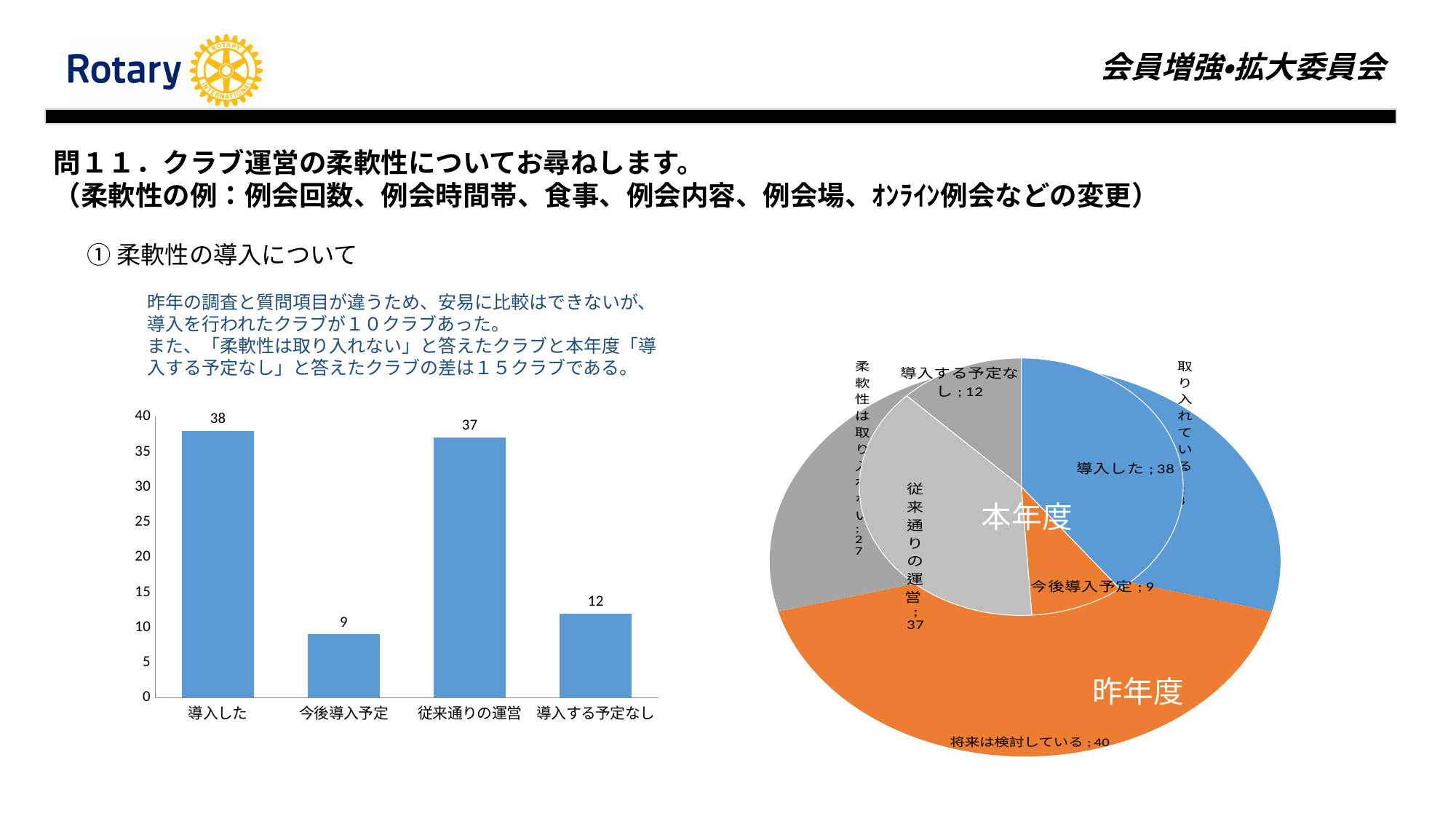
In the bar chart on the left, what is the value for 導入する予定なし? 12 In the bar chart on the left, what is the value for 導入した? 38 In the pie chart on the right, what is the value for 柔軟性は取り入れない in the 昨年度 ring? 27 In the bar chart on the left, which category has the highest value? 導入した In the bar chart on the left, which is larger, 従来通りの運営 or 今後導入予定? 従来通りの運営 In the bar chart on the left, which category has the lowest value? 今後導入予定 In the bar chart on the left, what is the value for 従来通りの運営? 37 In the bar chart on the left, what is the difference between 導入した and 導入する予定なし? 26 How many categories are shown in the bar chart on the left? 4 In the pie chart on the right, what is the value for 将来は検討している in the 昨年度 ring? 40 What kind of chart is on the left side of the slide? bar chart In the bar chart on the left, what is the value for 今後導入予定? 9